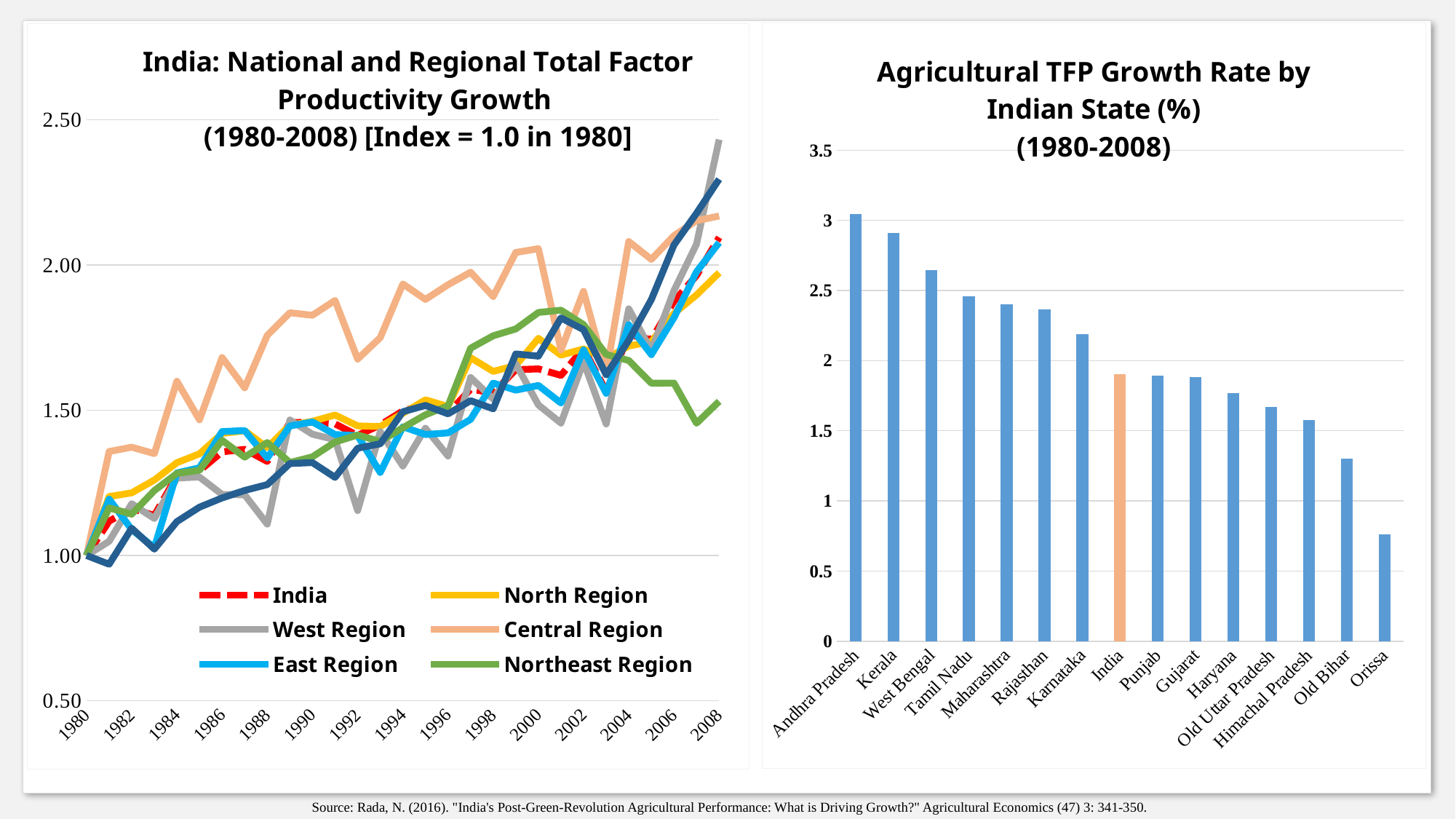
What kind of chart is the right chart, 'Agricultural TFP Growth Rate by Indian State (%)'? Bar chart In the left chart, which series has the highest value in 2008? West Region How many series does the legend of the left chart list? 6 In the right chart, which state has the highest agricultural TFP growth rate? Andhra Pradesh How many bars are shown in the right chart? 15 In the left chart, is the value for the Central Region in 2008 greater or less than 2.00? greater In the left chart, which series has the lowest value in 2008? Northeast Region What kind of chart is the left chart, 'India: National and Regional Total Factor Productivity Growth'? Line chart In the right chart, is the value for Orissa greater or less than 1? less In the right chart, which state has the lowest agricultural TFP growth rate? Orissa In the left chart, which series is drawn as a red dashed line? India In the left chart, do the values for the India series generally rise or fall from 1980 to 2008? Rise